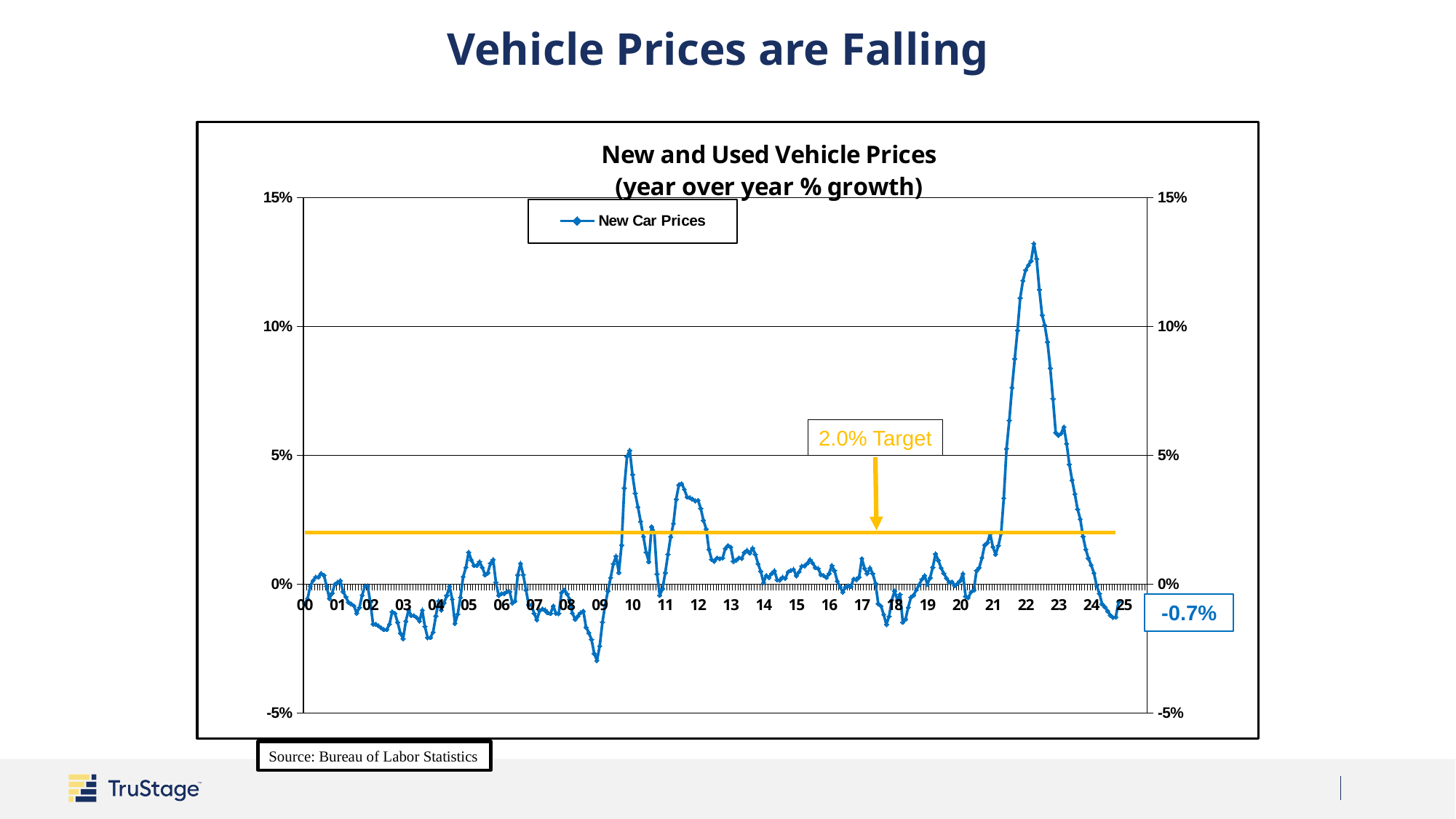
Is the New Car Prices growth value at the end of the series (2025) greater or less than the 2.0% target? less Is the peak value of New Car Prices growth around 2022 greater or less than 10%? greater Is the lowest value of New Car Prices growth around 2009 greater or less than 0%? less What kind of chart is shown on the slide? line chart What is the most recent value of New Car Prices growth labeled on the chart? -0.7% In which year on the x axis does New Car Prices growth reach its highest peak? 22 What target level is marked by the horizontal line on the chart? 2.0% Target What is the title of the chart? New and Used Vehicle Prices (year over year % growth) What series name appears in the chart legend? New Car Prices How many series does the chart legend list? 1 Does New Car Prices growth rise or fall between 2022 and 2025? fall How many year labels are shown on the x axis? 26